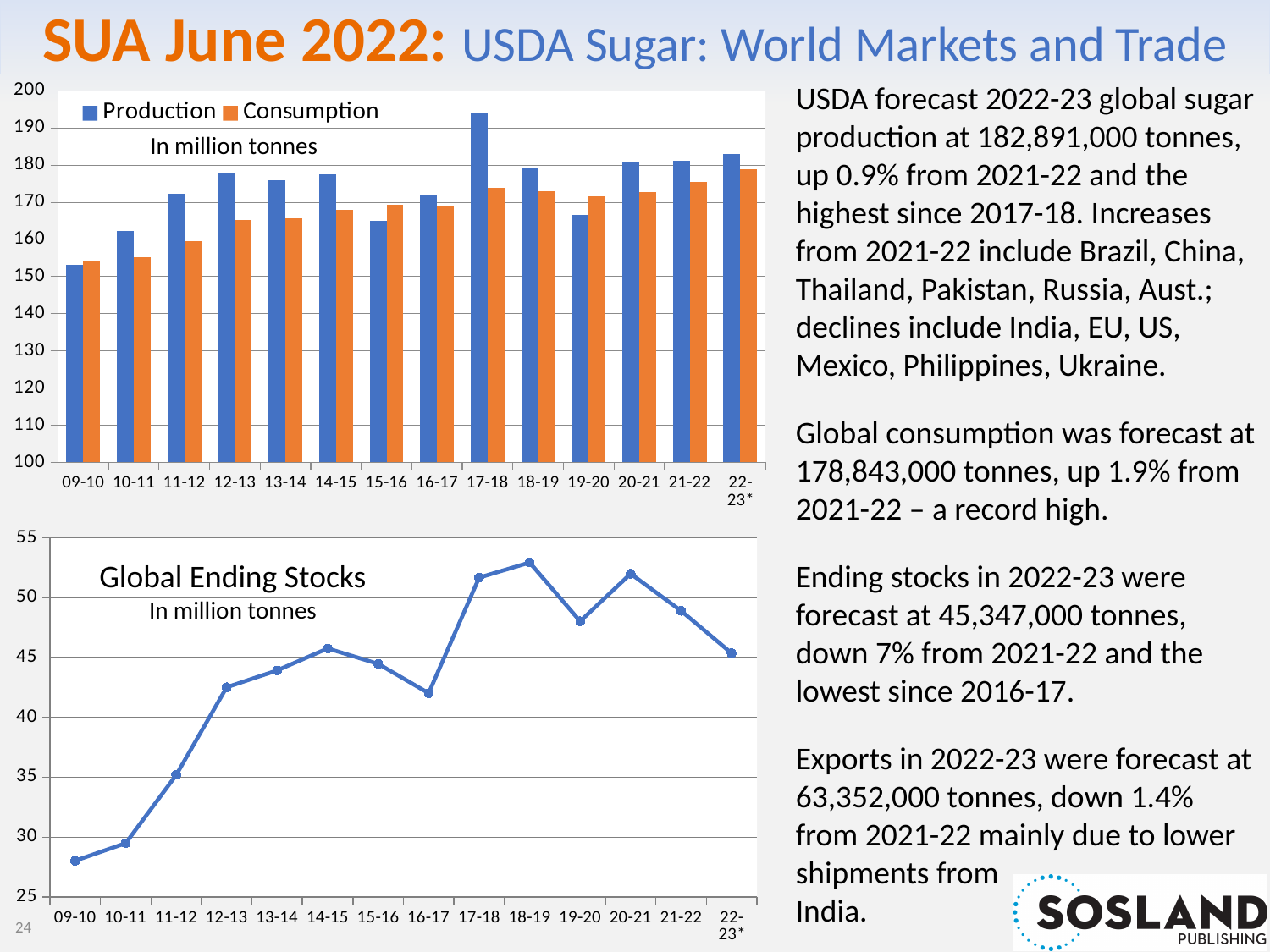
In the top Production and Consumption chart, which season has the lowest Production? 09-10 In the top Production and Consumption chart, is Production for 15-16 greater or less than 170? less How many seasons are shown on the x axis of the Global Ending Stocks chart? 14 In the top Production and Consumption chart, which season has the highest Production? 17-18 How many series does the legend of the top Production and Consumption chart list? 2 In the Global Ending Stocks chart, which season has the highest value? 18-19 In the Global Ending Stocks chart, which season has the lowest value? 09-10 In the Global Ending Stocks chart, is the value for 16-17 greater or less than 45? less In the top Production and Consumption chart, is Production for 17-18 greater or less than 190? greater What kind of chart is the top chart showing Production and Consumption? bar chart What kind of chart is the Global Ending Stocks chart? line chart In the top Production and Consumption chart, which is larger for 19-20, Production or Consumption? Consumption